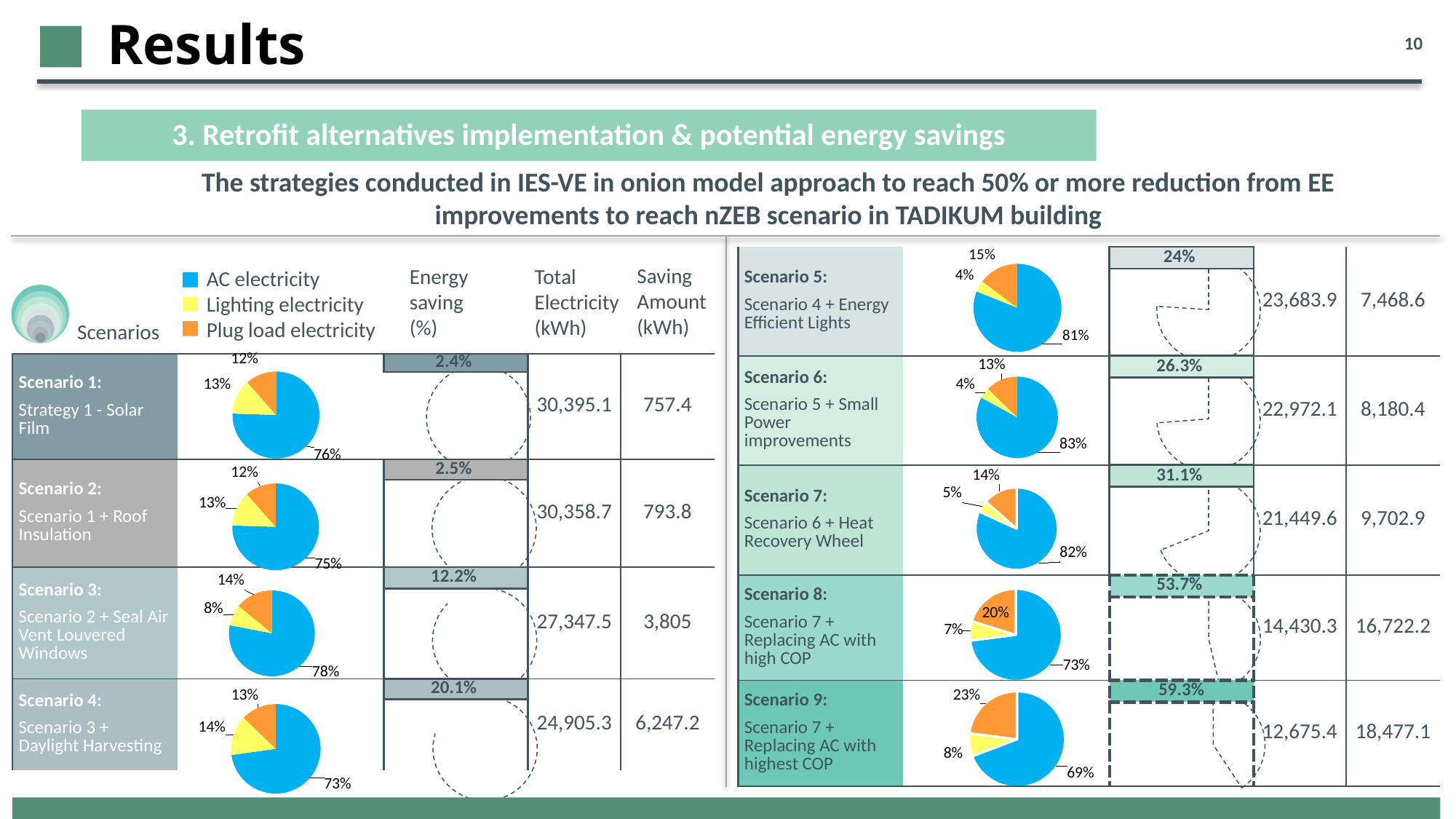
In the Scenario 6 pie chart, what is the difference between the AC electricity share and the plug load electricity share? 70% In the Scenario 5 pie chart, what share is lighting electricity? 4% How many slices does the Scenario 7 pie chart have? 3 In the Scenario 1 pie chart, what share is AC electricity? 76% In the Scenario 3 pie chart, which category has the smallest slice? Lighting electricity In the Scenario 2 pie chart, what share is plug load electricity? 12% How many categories does the legend for the pie charts list? 3 What type of chart is used to show the electricity breakdown for each scenario? Pie chart In the Scenario 4 pie chart, which is larger: lighting electricity or plug load electricity? Lighting electricity In the legend for the pie charts, which colour represents plug load electricity? Orange In the Scenario 8 pie chart, which category has the largest slice? AC electricity